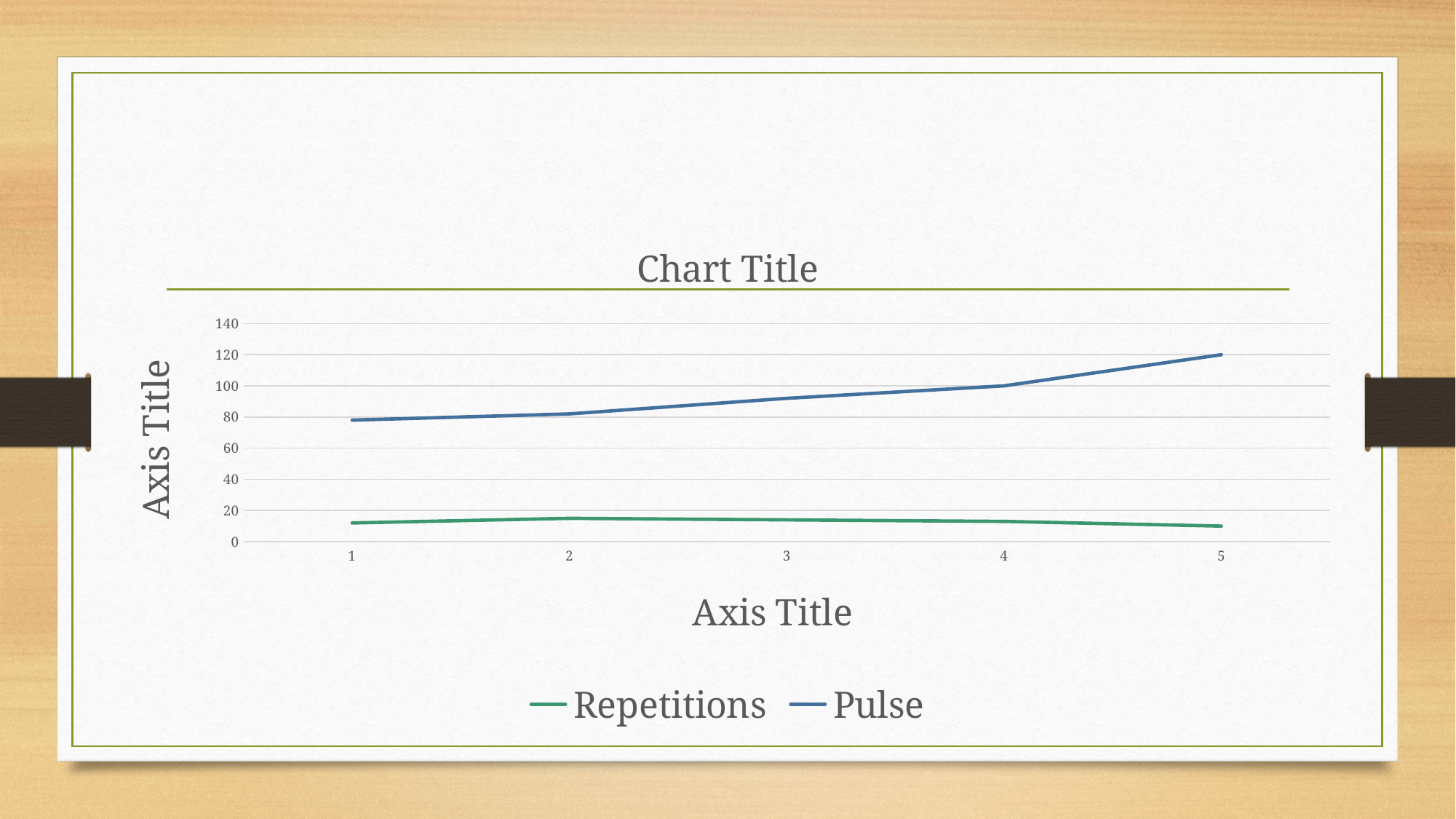
Does the Pulse series rise or fall from x = 1 to x = 5? rise What is the title of the chart? Chart Title What kind of chart is shown on the slide? line chart How many series does the legend list? 2 Is the Repetitions value at x = 3 greater or less than 40? less At which x value does the Pulse series reach its highest point? 5 What are the names of the series in the legend? Repetitions and Pulse Is the Pulse value at x = 1 greater or less than 100? less How many points are plotted along the x axis for each series? 5 Is the Pulse value at x = 1 greater or less than 60? greater Which series has the higher value at x = 3, Repetitions or Pulse? Pulse What is the Pulse value at x = 5? 120